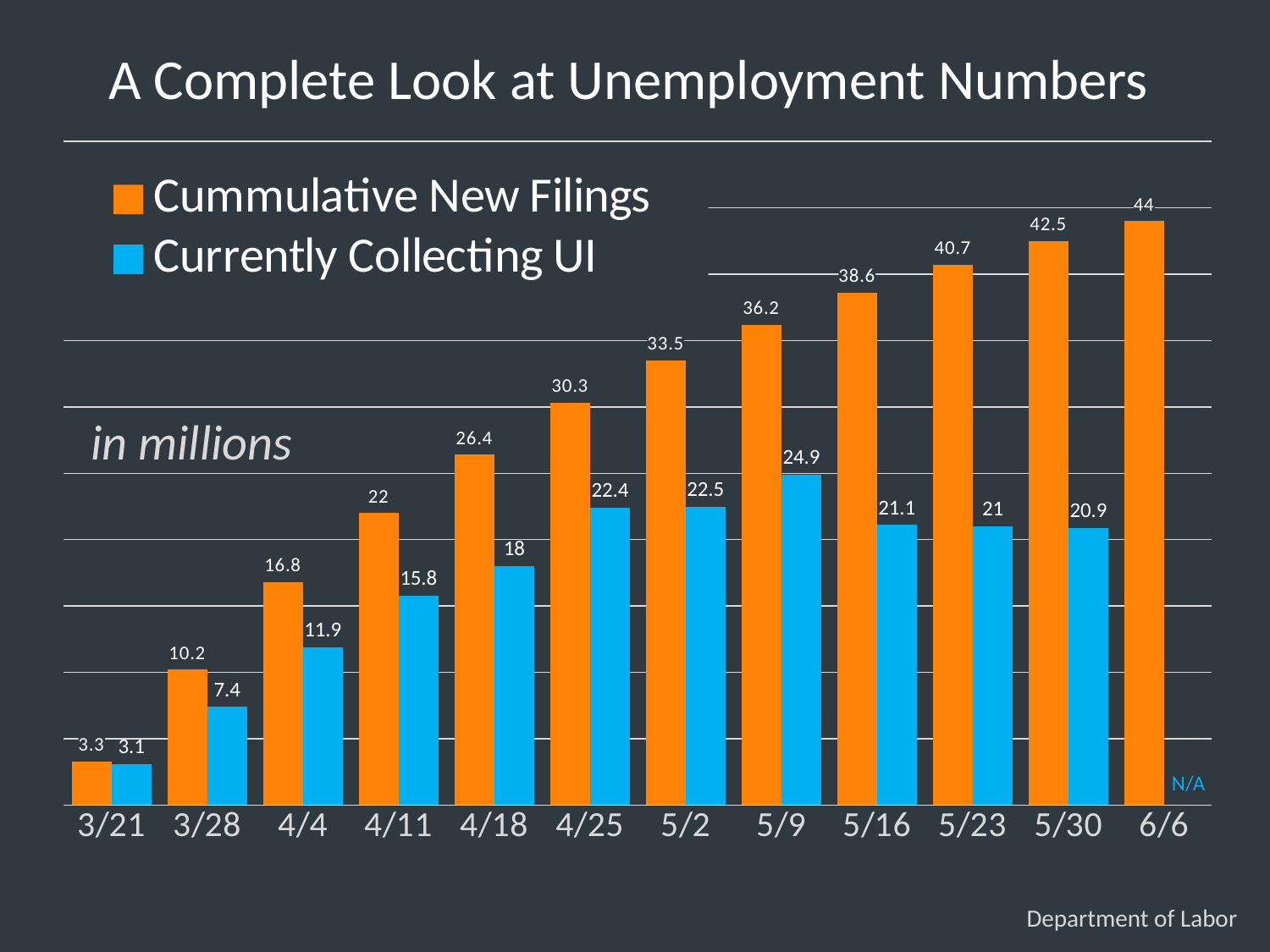
How many series does the legend list? 2 Which date has the lowest Currently Collecting UI value? 3/21 Do the Cummulative New Filings values rise or fall from 3/21 to 6/6? Rise Which is larger on 4/11: Cummulative New Filings or Currently Collecting UI? Cummulative New Filings What kind of chart is shown on the slide? Bar chart What is the value of Currently Collecting UI for 6/6? N/A What is the difference between Cummulative New Filings and Currently Collecting UI on 5/30? 21.6 Which date has the highest Currently Collecting UI value? 5/9 Which date has the highest Cummulative New Filings value? 6/6 How many dates are shown on the x axis? 12 What is the value of Currently Collecting UI for 4/18? 18 What is the value of Cummulative New Filings for 5/9? 36.2